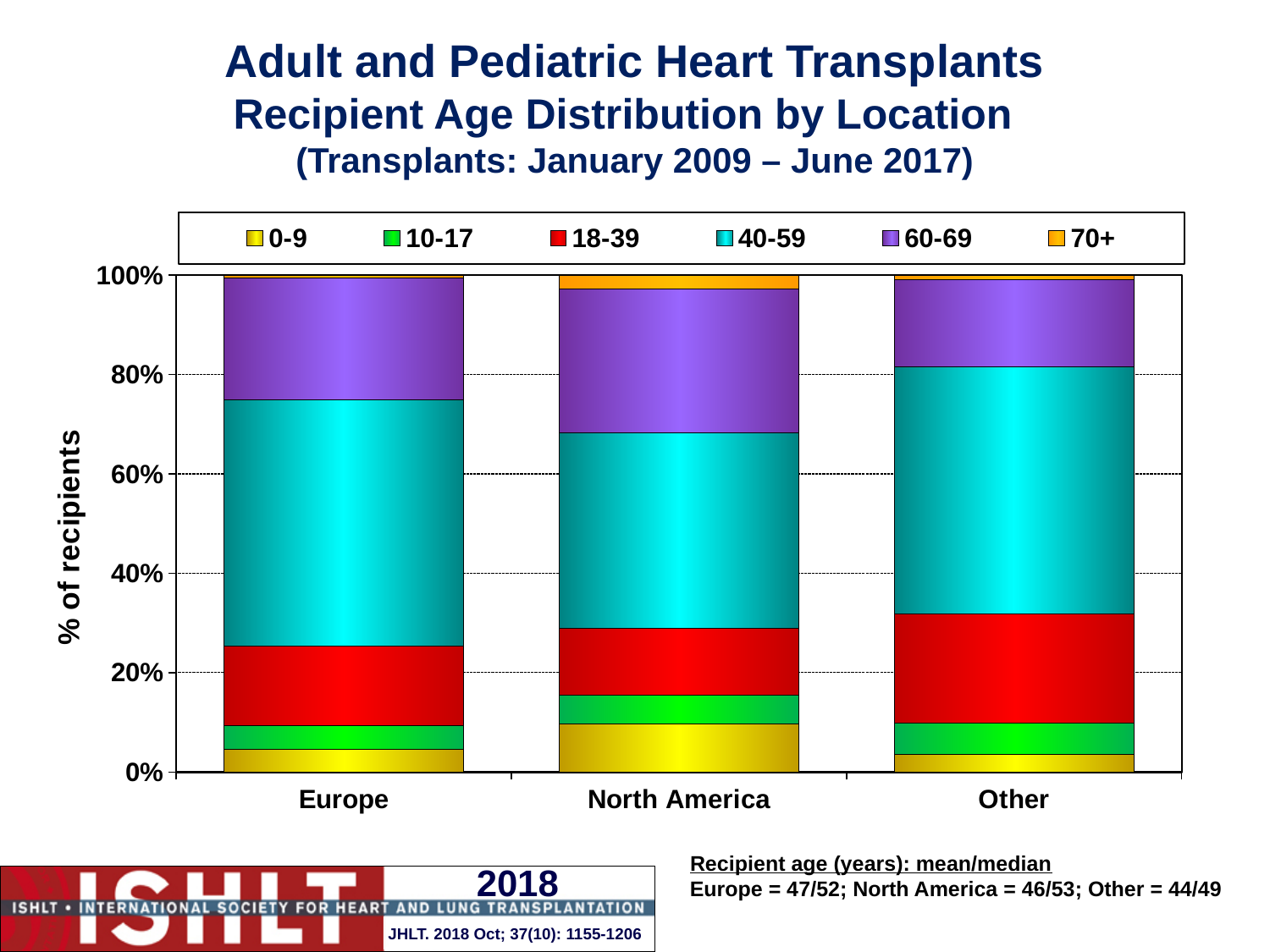
Which location has the larger 18-39 share, Europe or Other? Other What kind of chart is shown on the slide? Stacked bar chart Which location has the largest 70+ share? North America How many locations are shown along the x axis? 3 Which location has the larger 60-69 share, North America or Other? North America Is the 0-9 segment for North America greater or less than 20% of recipients? less Is the 18-39 segment for Other greater or less than 20% of recipients? greater Which location has the larger 0-9 share, Europe or North America? North America Which location has the smallest 40-59 share? North America Is the 40-59 segment for Europe greater or less than 40% of recipients? greater How many age groups does the legend list? 6 What is the label on the y axis? % of recipients